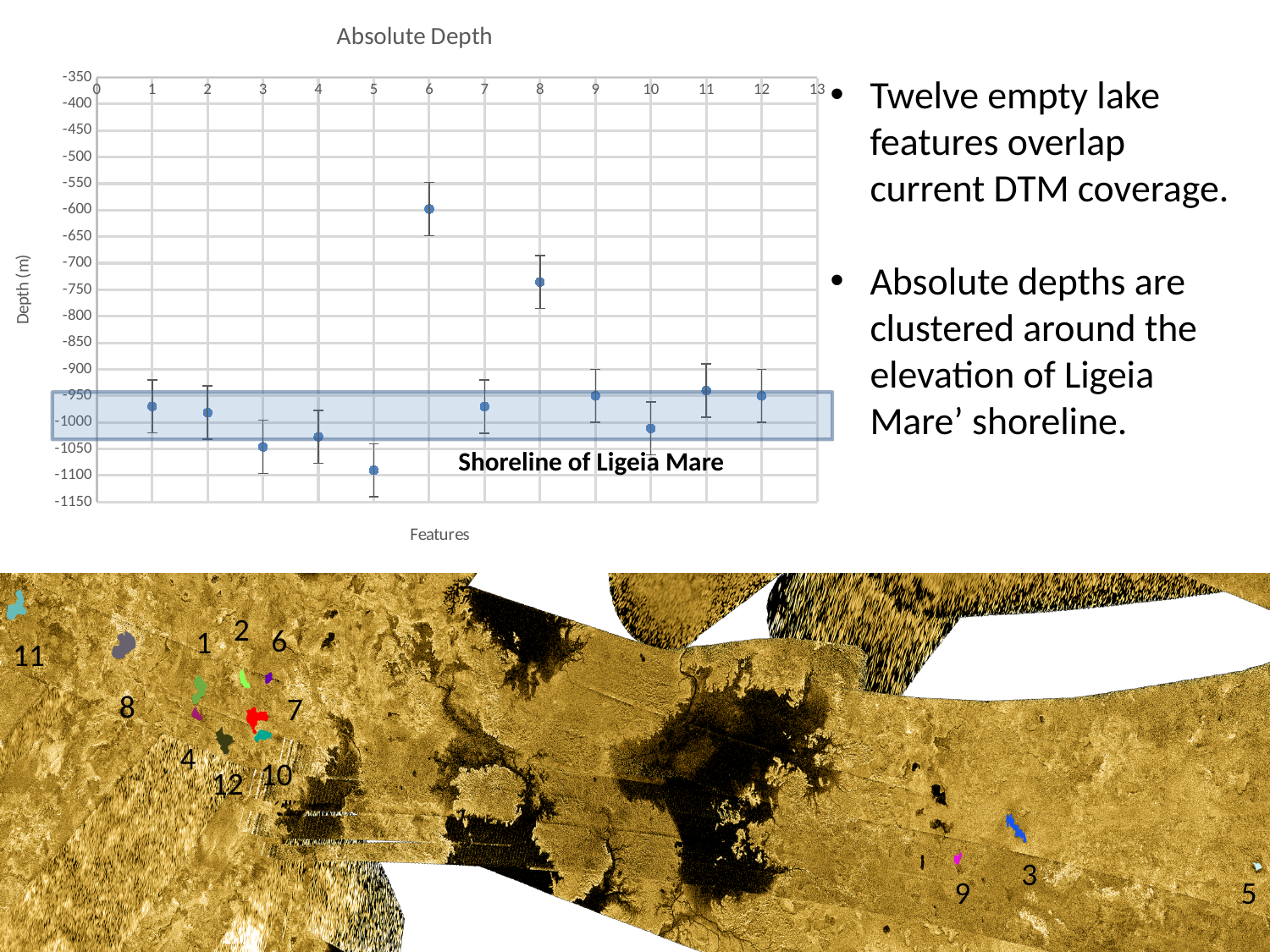
Is the value for feature 9 greater or less than -1000? greater Which feature has the lowest (deepest) absolute depth value in the chart? 5 Which has the larger value, feature 3 or feature 9? feature 9 How many features (data points) are plotted in the chart? 12 What kind of chart is shown on the slide? scatter chart Is the value for feature 5 greater or less than -1050? less Which feature has the highest (shallowest) absolute depth value in the chart? 6 Is the value for feature 6 greater or less than -650? greater What label is given to the shaded horizontal band in the chart? Shoreline of Ligeia Mare What is the title of the chart? Absolute Depth Which has the larger value, feature 6 or feature 8? feature 6